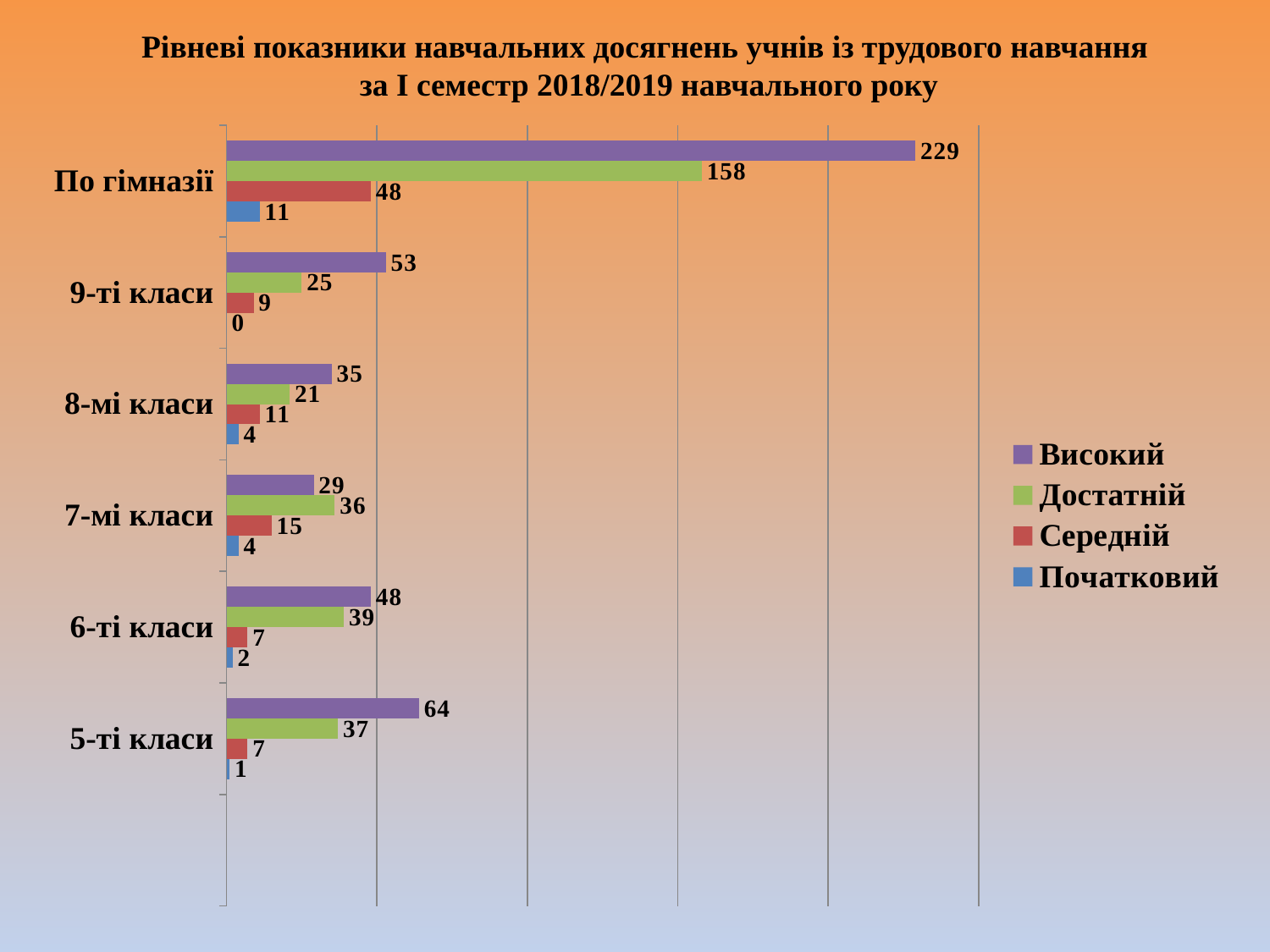
How many categories are shown on the vertical axis? 6 Among the class categories (excluding По гімназії), which has the lowest Достатній value? 8-мі класи What is the value of Високий for По гімназії? 229 What is the difference between the Високий and Достатній values for По гімназії? 71 How many series does the legend list? 4 What is the value of Достатній for 7-мі класи? 36 Which series is shown in green in the legend? Достатній Which is larger for 7-мі класи: Високий or Достатній? Достатній Among the class categories (excluding По гімназії), which has the highest Високий value? 5-ті класи What kind of chart is shown on the slide? Bar chart What is the value of Початковий for 9-ті класи? 0 What is the value of Середній for 6-ті класи? 7